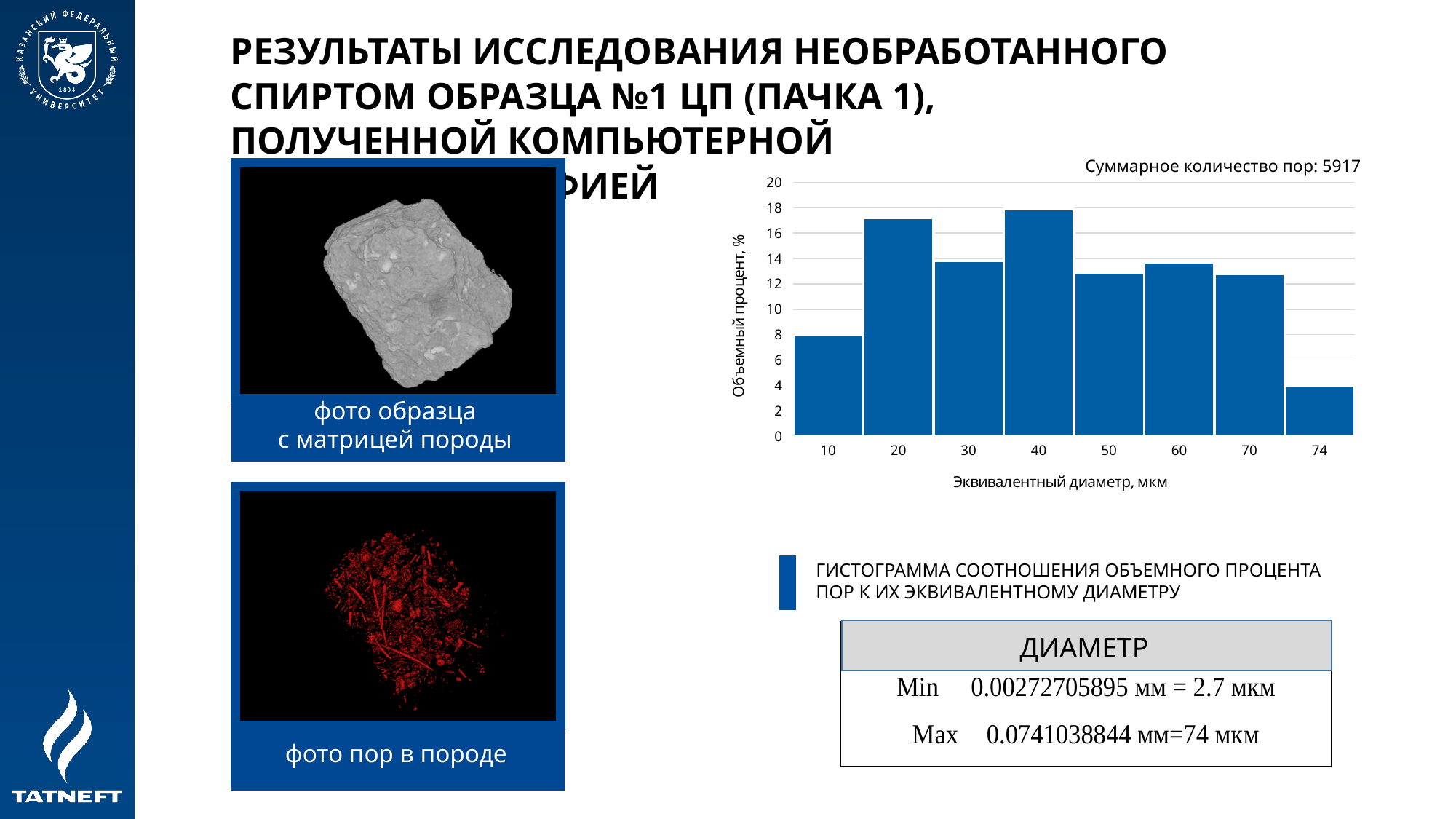
Is the volume percent for the 10 µm category greater or less than 10? less Is the volume percent for the 74 µm category greater or less than 6? less Which equivalent diameter category has the lowest volume percent? 74 What kind of chart is shown on the slide? bar chart What is the label of the x axis of the chart? Эквивалентный диаметр, мкм Which equivalent diameter category has the highest volume percent? 40 How many bars (equivalent diameter categories) does the chart show? 8 Is the volume percent for the 50 µm category greater or less than 12? greater What total number of pores is stated above the chart? 5917 Which has a larger volume percent: the 20 µm category or the 10 µm category? 20 Which has a larger volume percent: the 50 µm category or the 74 µm category? 50